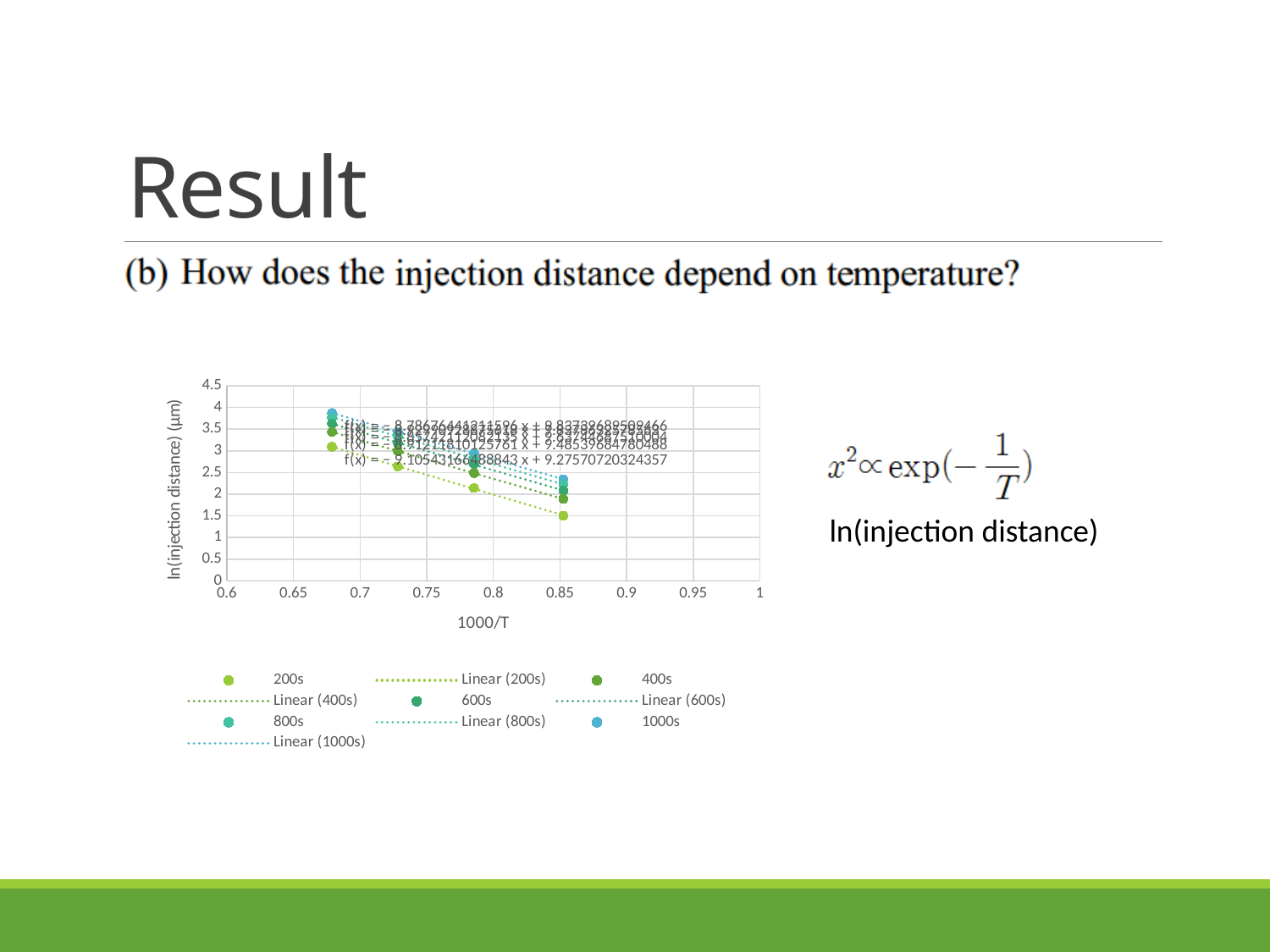
Is the value for the 1000s series at the leftmost data point (1000/T ≈ 0.68) greater or less than 3.5? greater At the rightmost data point (1000/T ≈ 0.85), which series has the larger value, 1000s or 200s? 1000s What is the label of the x axis of the chart? 1000/T Do the plotted values rise or fall as 1000/T increases along the x axis? fall How many distinct 1000/T positions have data points plotted for each series? 4 What kind of chart is shown on the slide? scatter chart Is the value for the 200s series at the rightmost data point (1000/T ≈ 0.85) greater or less than 2? less What is the label of the y axis of the chart? ln(injection distance) (μm) How many entries does the chart legend list? 10 Which series has the lowest ln(injection distance) values across the chart? 200s Which series has the highest ln(injection distance) values across the chart? 1000s